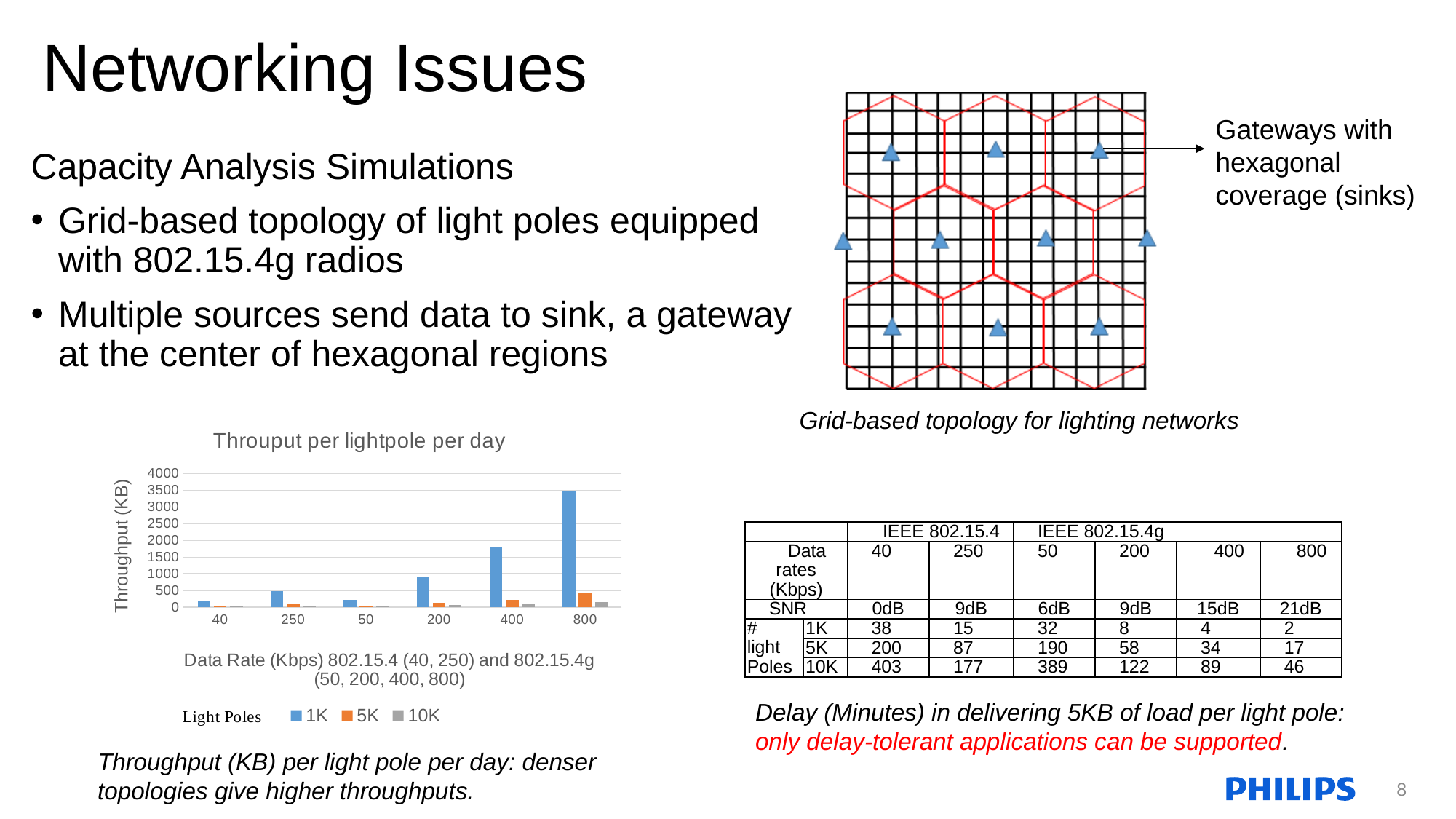
Is the 1K value at data rate 800 greater or less than 3000? greater Which is larger in the chart: the 1K value at data rate 800 or the 1K value at data rate 400? 800 What is the title of the chart on the slide? Throuput per lightpole per day What is the label on the y axis of the chart? Throughput (KB) Is the 1K value at data rate 40 greater or less than 500? less Is the 1K value at data rate 200 greater or less than 500? greater Do the 1K values rise or fall across the 802.15.4g data rates 50, 200, 400 and 800? rise What kind of chart is shown on the slide? bar chart How many series does the chart's legend list? 3 Which data-rate category has the highest 1K bar in the chart? 800 How many data-rate categories are shown on the x axis of the chart? 6